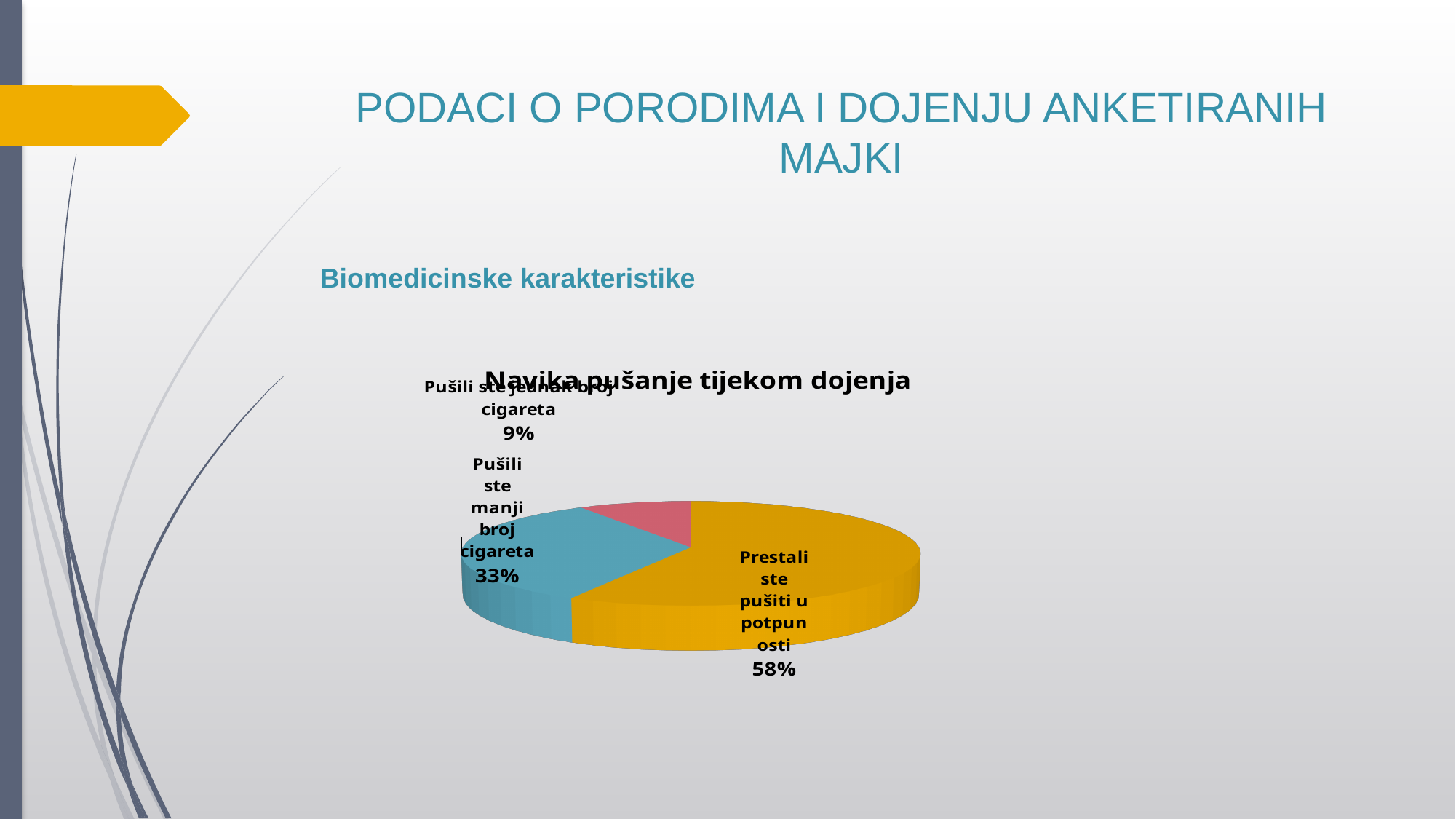
Which category has the smallest share of the pie? Pušili ste jednak broj cigareta What kind of chart is shown on the slide? pie chart What colour is the slice for "Prestali ste pušiti u potpunosti"? yellow/orange What share of the pie is labelled "Pušili ste jednak broj cigareta"? 9% Which is larger: the share for "Pušili ste manji broj cigareta" or the share for "Pušili ste jednak broj cigareta"? Pušili ste manji broj cigareta What is the difference in percentage points between "Pušili ste manji broj cigareta" and "Pušili ste jednak broj cigareta"? 24 percentage points What share of the pie is labelled "Pušili ste manji broj cigareta"? 33% What is the title of the chart? Navika pušanje tijekom dojenja How many slices does the pie chart have? 3 Which category has the largest share of the pie? Prestali ste pušiti u potpunosti What is the difference in percentage points between "Prestali ste pušiti u potpunosti" and "Pušili ste manji broj cigareta"? 25 percentage points What share of the pie is labelled "Prestali ste pušiti u potpunosti"? 58%